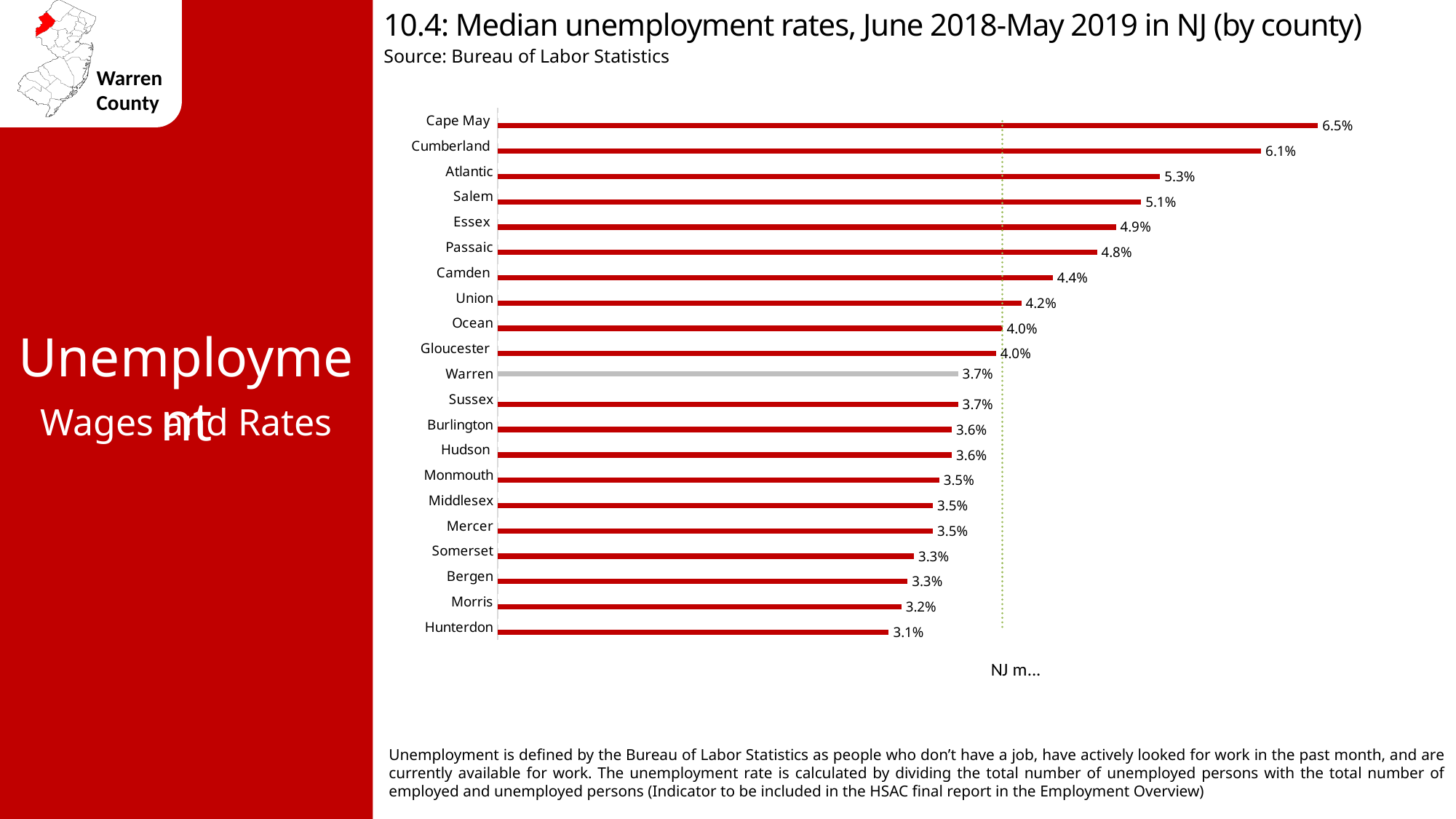
Which county's bar is shown in grey instead of red? Warren Which has a higher median unemployment rate, Morris or Passaic? Passaic What is the median unemployment rate for Warren county? 3.7% What is the median unemployment rate for Cumberland county? 6.1% What is the difference between the median unemployment rates of Atlantic and Warren? 1.6% What is the median unemployment rate for Camden county? 4.4% Which county has the lowest median unemployment rate? Hunterdon How many counties are shown in the chart? 21 What kind of chart is used to show the median unemployment rates? Bar chart What is the difference between the median unemployment rates of Cape May and Hunterdon? 3.4% Which has a higher median unemployment rate, Essex or Union? Essex Which county has the highest median unemployment rate? Cape May